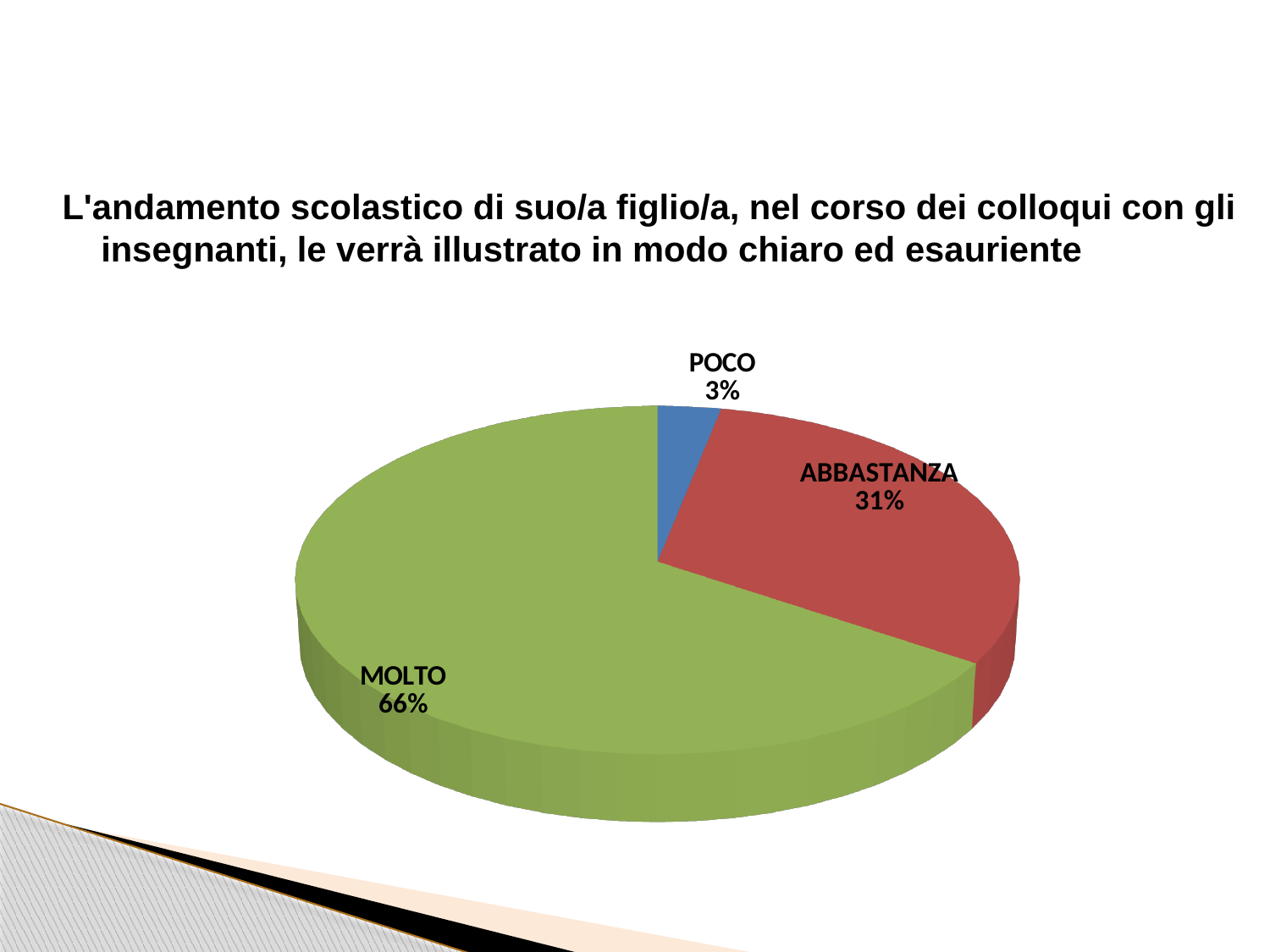
Which category has the smallest slice of the pie? POCO What share of the pie does ABBASTANZA represent? 31% Which is larger, the share for ABBASTANZA or the share for POCO? ABBASTANZA Which category has the largest slice of the pie? MOLTO What is the difference in percentage points between MOLTO and ABBASTANZA? 35 What share of the pie does POCO represent? 3% What is the difference in percentage points between ABBASTANZA and POCO? 28 What kind of chart is shown on the slide? pie chart What share of the pie does MOLTO represent? 66% How many slices does the pie chart have? 3 What colour is the POCO slice? blue What colour is the MOLTO slice? green